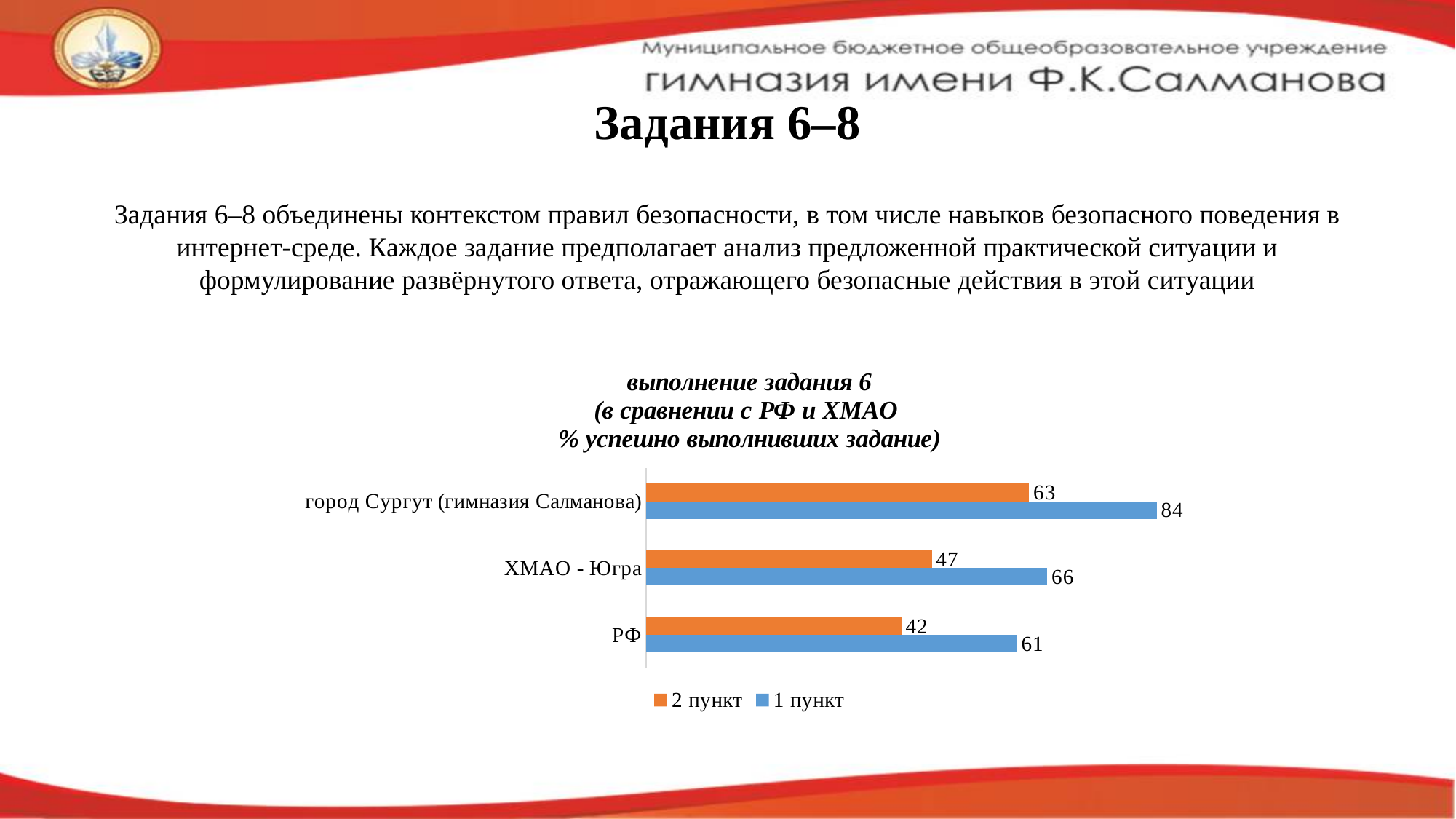
Which category has the highest value for "1 пункт"? город Сургут (гимназия Салманова) Which is larger: the "2 пункт" value for город Сургут (гимназия Салманова) or the "1 пункт" value for РФ? 2 пункт for город Сургут (гимназия Салманова) How many series does the legend list? 2 How many categories are shown on the chart? 3 What is the difference between the "1 пункт" and "2 пункт" values for ХМАО - Югра? 19 What is the difference between the "1 пункт" values for город Сургут (гимназия Салманова) and РФ? 23 What is the value of "2 пункт" for РФ? 42 Which category has the lowest value for "2 пункт"? РФ What is the value of "1 пункт" for город Сургут (гимназия Салманова)? 84 What is the value of "2 пункт" for ХМАО - Югра? 47 What kind of chart is shown on the slide? bar chart What is the value of "1 пункт" for РФ? 61